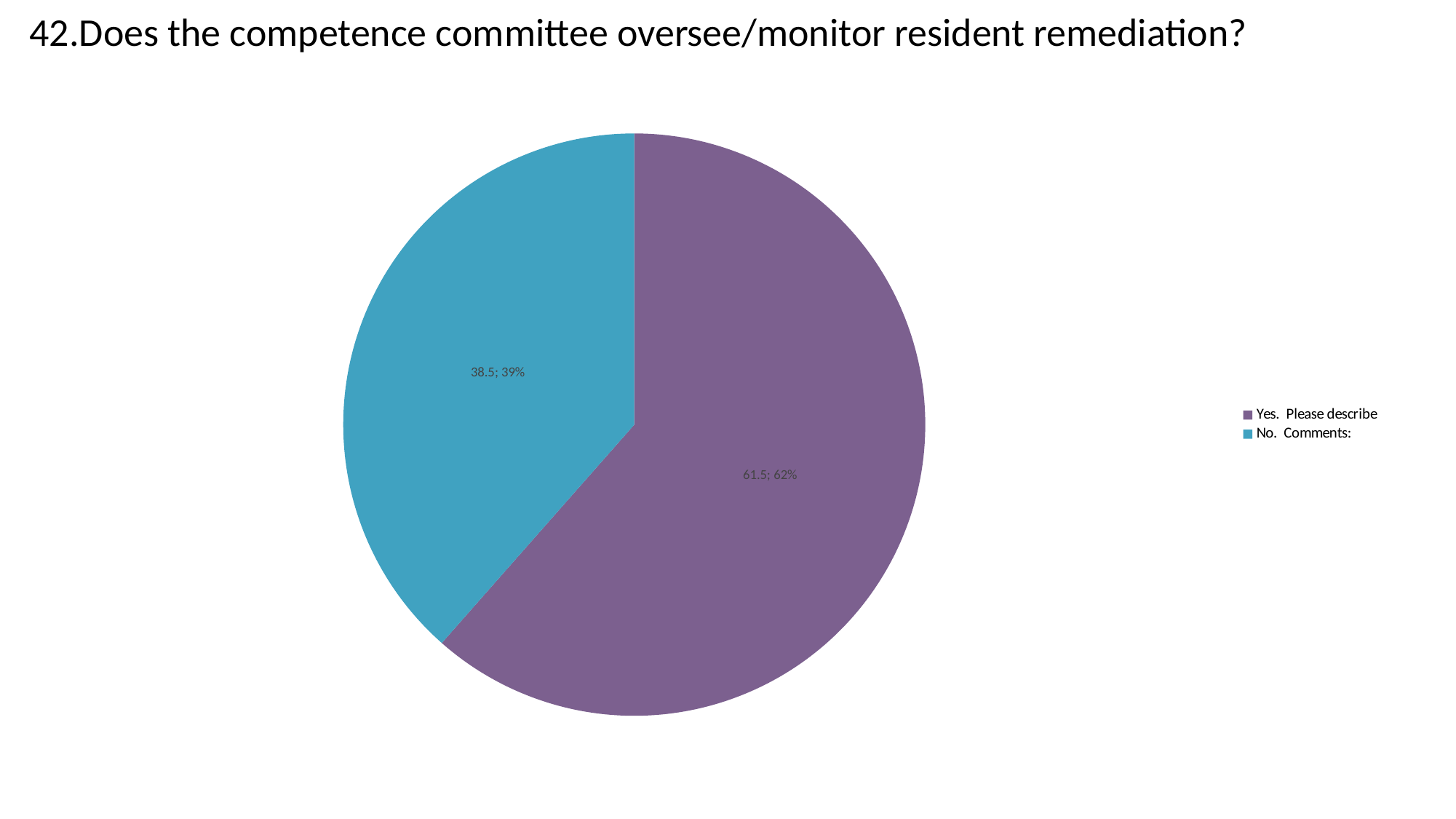
Which slice is the largest? Yes. Please describe What value is shown for the "No. Comments:" slice? 38.5 What percentage share does the "No. Comments:" slice have? 39% What colour is the "No. Comments:" slice? blue What is the difference between the values for "Yes. Please describe" and "No. Comments:"? 23 How many entries does the legend list? 2 What percentage share does the "Yes. Please describe" slice have? 62% How many slices does the pie chart have? 2 Which slice is the smallest? No. Comments: Which is larger, the "Yes. Please describe" slice or the "No. Comments:" slice? Yes. Please describe What kind of chart is shown on the slide? pie chart What value is shown for the "Yes. Please describe" slice? 61.5